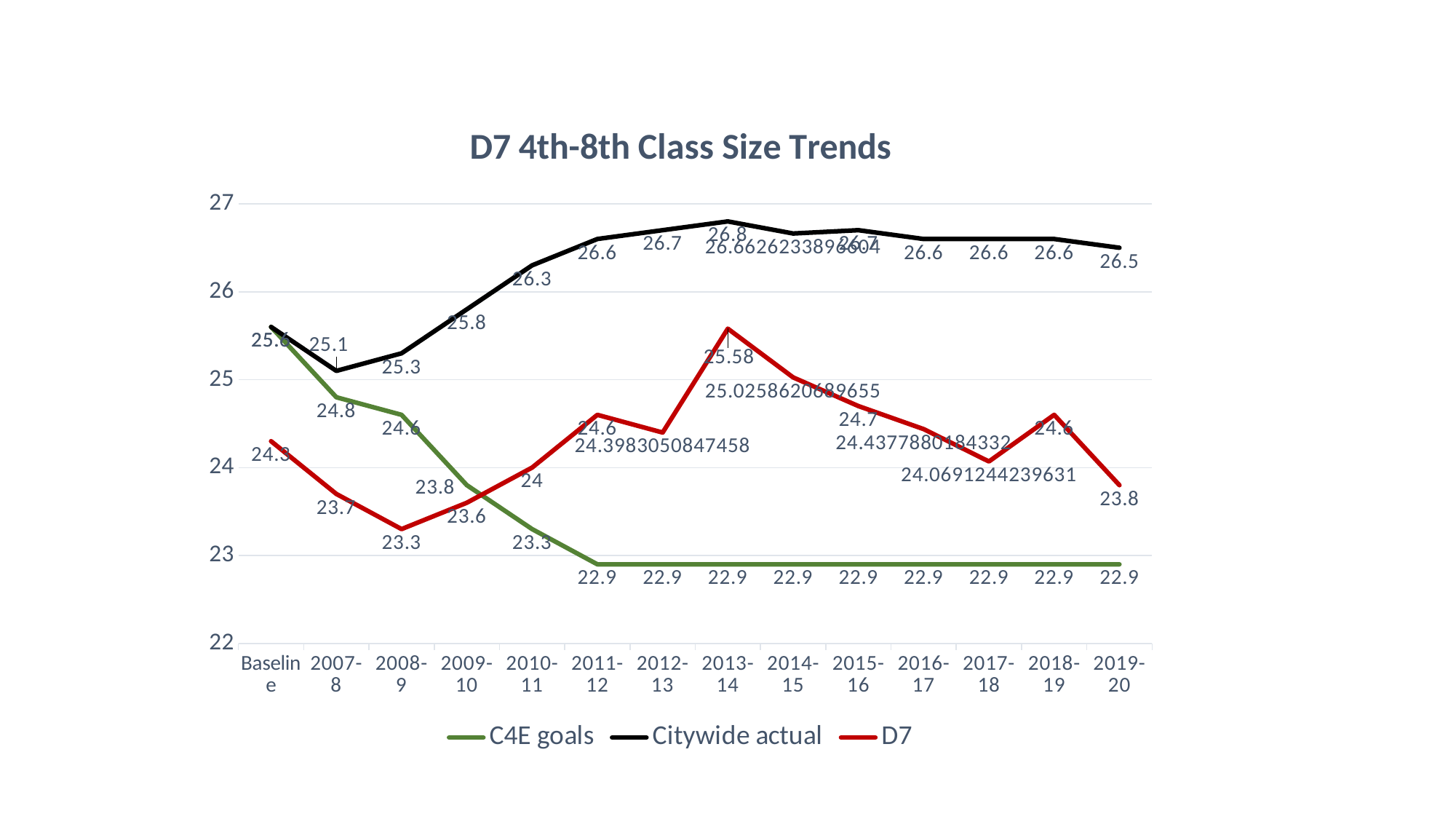
What is the Citywide actual value for 2019-20? 26.5 What is the C4E goals value for 2019-20? 22.9 What is the difference between the Citywide actual and C4E goals values in 2019-20? 3.6 In 2012-13, which is larger: the D7 value or the Citywide actual value? Citywide actual How many categories are shown along the x axis? 14 In which year is the Citywide actual series at its lowest? 2007-8 What kind of chart is shown on the slide? line chart What is the D7 value for 2008-9? 23.3 What is the D7 value for 2013-14? 25.58 Do the C4E goals values rise or fall from Baseline to 2011-12? fall How many series does the legend list? 3 In which year is the D7 series at its highest? 2013-14